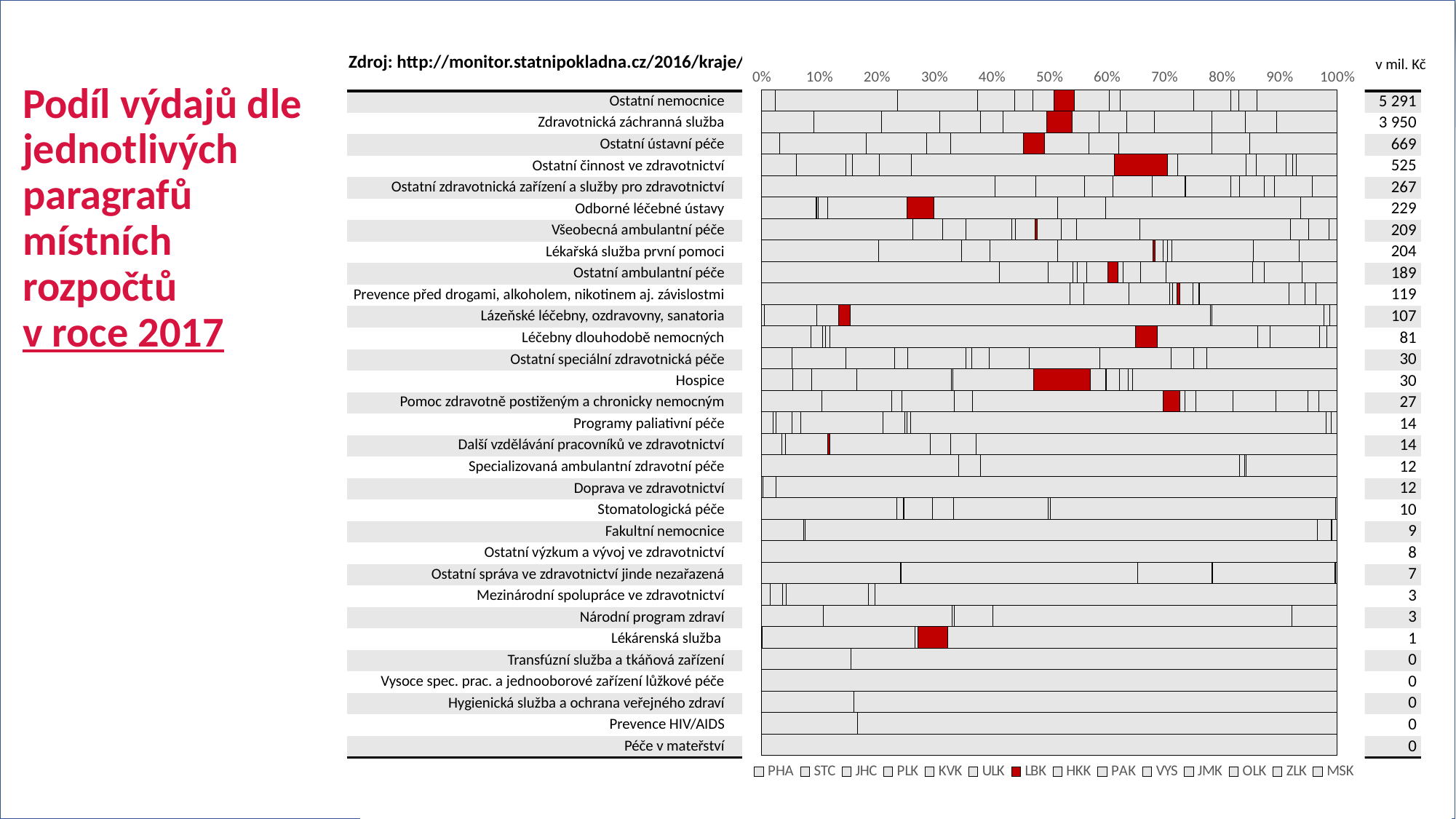
What kind of chart is shown on the slide? bar chart What is the value in mil. Kč shown for Hospice? 30 Which series is highlighted in red in the chart? LBK What is the difference in mil. Kč between Ostatní nemocnice and Zdravotnická záchranná služba? 1 341 How many categories (rows) are plotted in the chart? 31 How many series does the legend list? 14 What is the first entry in the chart legend? PHA Which category has the highest value in mil. Kč? Ostatní nemocnice What is the value in mil. Kč shown for Odborné léčebné ústavy? 229 What is the value in mil. Kč shown for Zdravotnická záchranná služba? 3 950 What is the value in mil. Kč shown for Ostatní nemocnice? 5 291 Which has a larger value in mil. Kč, Ostatní ústavní péče or Ostatní činnost ve zdravotnictví? Ostatní ústavní péče